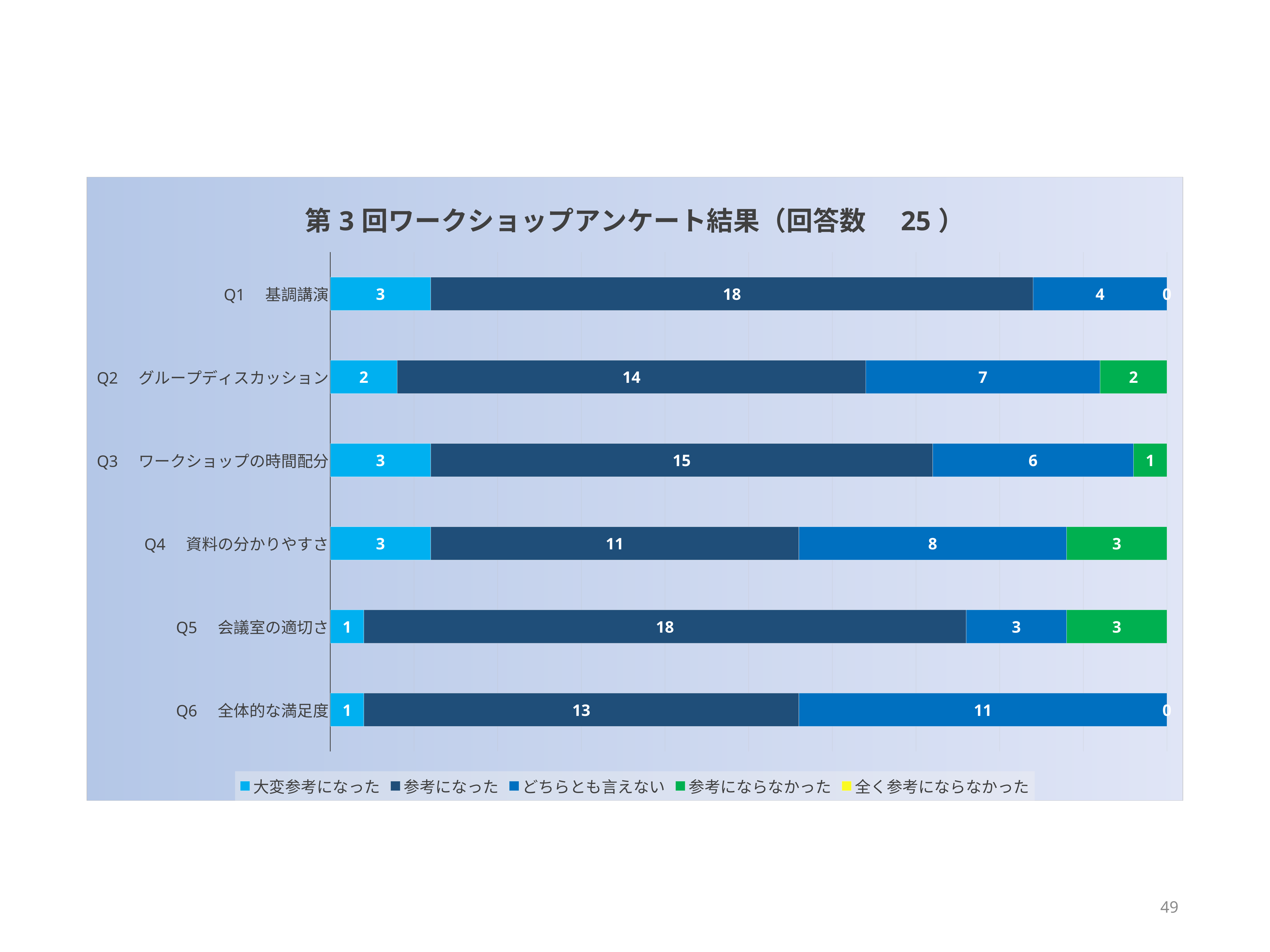
What is the total of the stacked bar for Q4 資料の分かりやすさ? 25 What is the value of どちらとも言えない for Q6 全体的な満足度? 11 What type of chart is shown on the slide? Stacked bar chart How many categories (questions) are plotted on the chart? 6 What is the value of 参考になった for Q1 基調講演? 18 What is the value of 参考にならなかった for Q4 資料の分かりやすさ? 3 Which category has the lowest value for 参考になった? Q4 資料の分かりやすさ How many series does the legend list? 5 What is the difference between the 参考になった values for Q1 基調講演 and Q2 グループディスカッション? 4 Which is larger: the どちらとも言えない value for Q2 グループディスカッション or for Q3 ワークショップの時間配分? Q2 グループディスカッション Which category has the highest value for どちらとも言えない? Q6 全体的な満足度 What is the value of 大変参考になった for Q5 会議室の適切さ? 1